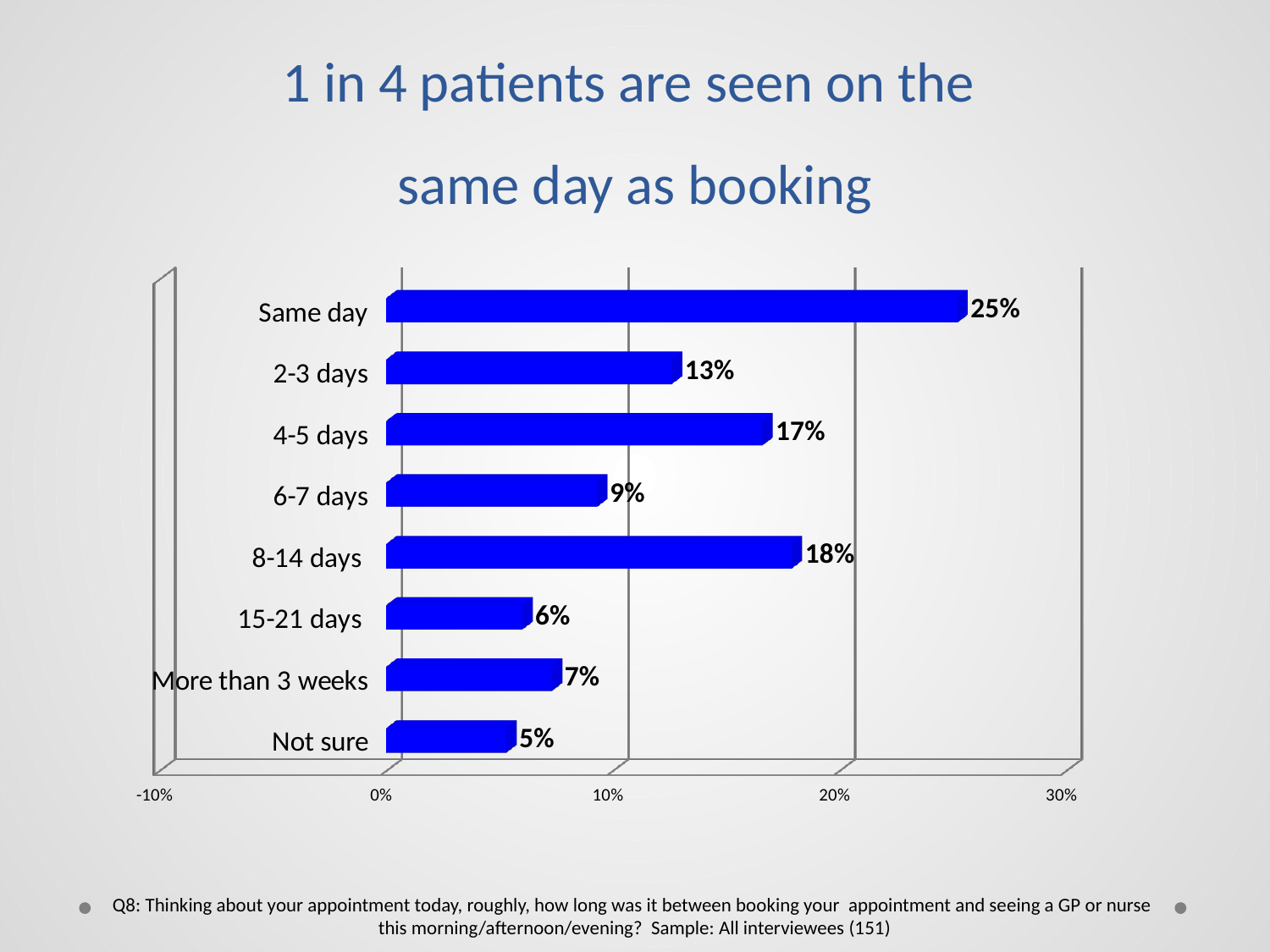
What is the sample size stated in the footnote of the slide? 151 What percentage of patients were seen the same day as booking? 25% Is the value for 6-7 days greater or less than 10%? less Which is larger, the value for 4-5 days or the value for 8-14 days? 8-14 days Which category has the lowest value? Not sure What is the value for the 8-14 days category? 18% What kind of chart is shown on the slide? bar chart How many categories are shown in the chart? 8 Which category has the highest value? Same day What is the difference between the 15-21 days value and the Not sure value? 1% What percentage of patients waited more than 3 weeks? 7% What is the difference between the Same day value and the 2-3 days value? 12%